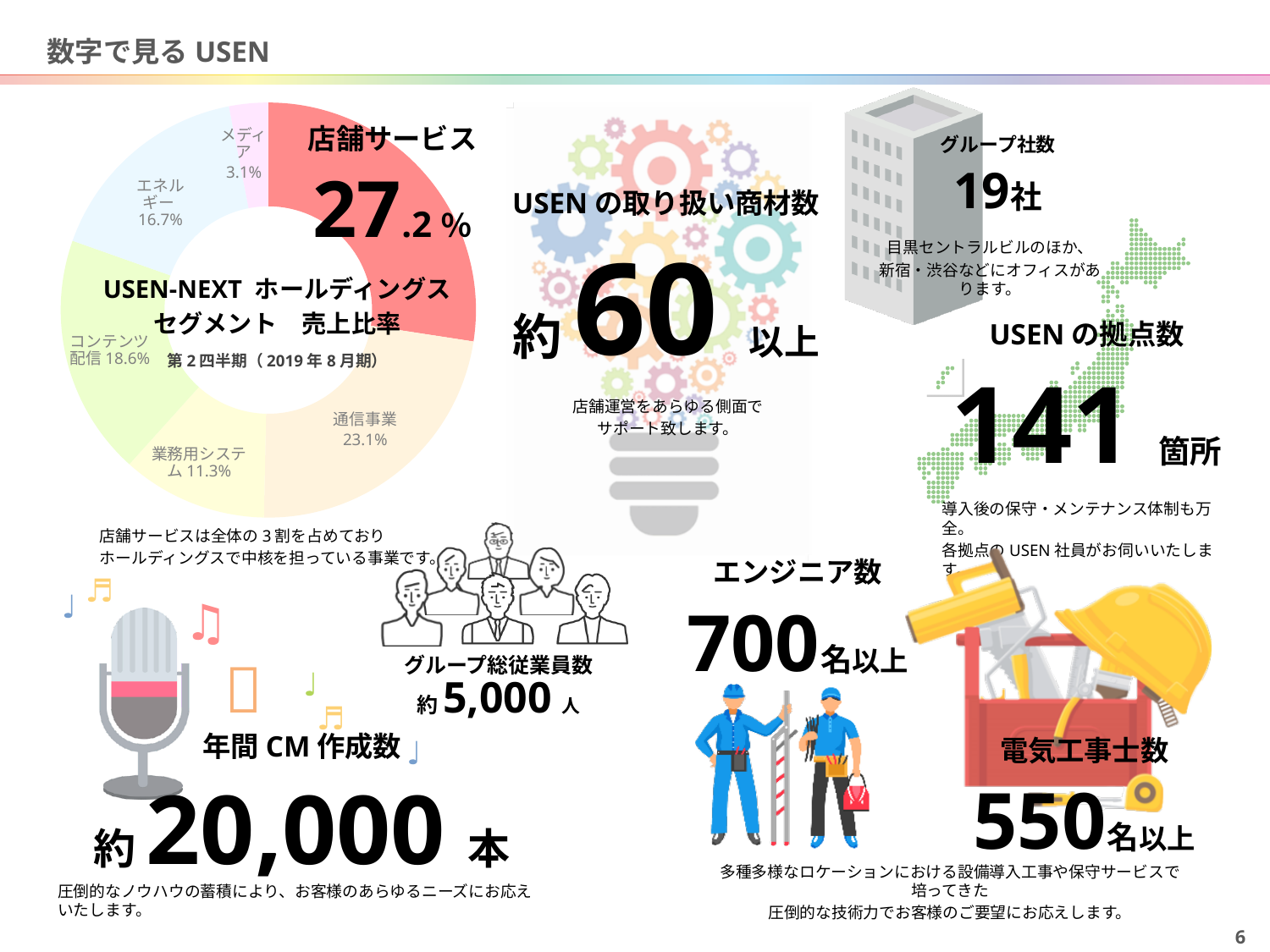
Which segment has the largest share in the donut chart? 店舗サービス Which segment has the smallest share in the donut chart? メディア What share of sales does コンテンツ配信 account for in the donut chart? 18.6% What share of sales does 店舗サービス account for in the donut chart? 27.2% What is the difference in percentage points between 店舗サービス and 通信事業 in the donut chart? 4.1 What share of sales does 通信事業 account for in the donut chart? 23.1% What is the title of the donut chart? USEN-NEXT ホールディングス セグメント 売上比率 In the donut chart, which is larger: コンテンツ配信 or エネルギー? コンテンツ配信 What kind of chart is shown on the left of the slide? Donut (pie) chart What share of sales does エネルギー account for in the donut chart? 16.7% How many segments are shown in the donut chart? 6 What share of sales does 業務用システム account for in the donut chart? 11.3%